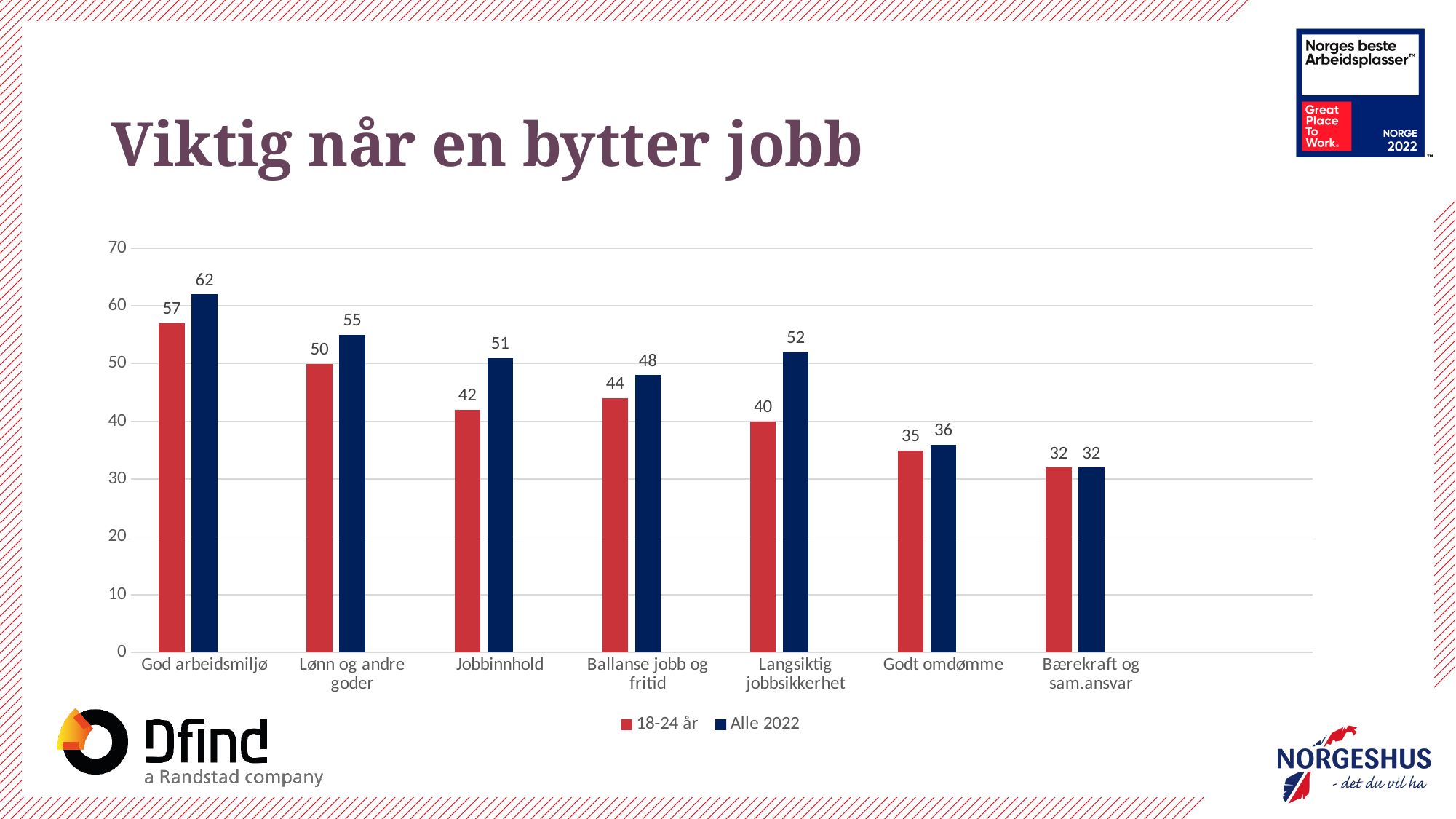
What kind of chart is shown on the slide? Bar chart What is the title of the slide? Viktig når en bytter jobb What is the difference between "Alle 2022" and "18-24 år" for "Langsiktig jobbsikkerhet"? 12 What is the value for "18-24 år" for "Jobbinnhold"? 42 Which category has the highest value for "Alle 2022"? God arbeidsmiljø How many series does the legend list? 2 How many categories are shown on the x axis? 7 What is the value for "Alle 2022" for "Langsiktig jobbsikkerhet"? 52 What is the value for "18-24 år" for "God arbeidsmiljø"? 57 Which category has the lowest value for "18-24 år"? Bærekraft og sam.ansvar Which is larger for "Lønn og andre goder": the value for "18-24 år" or for "Alle 2022"? Alle 2022 Do the values for "Alle 2022" generally rise or fall from left to right across the categories? Fall